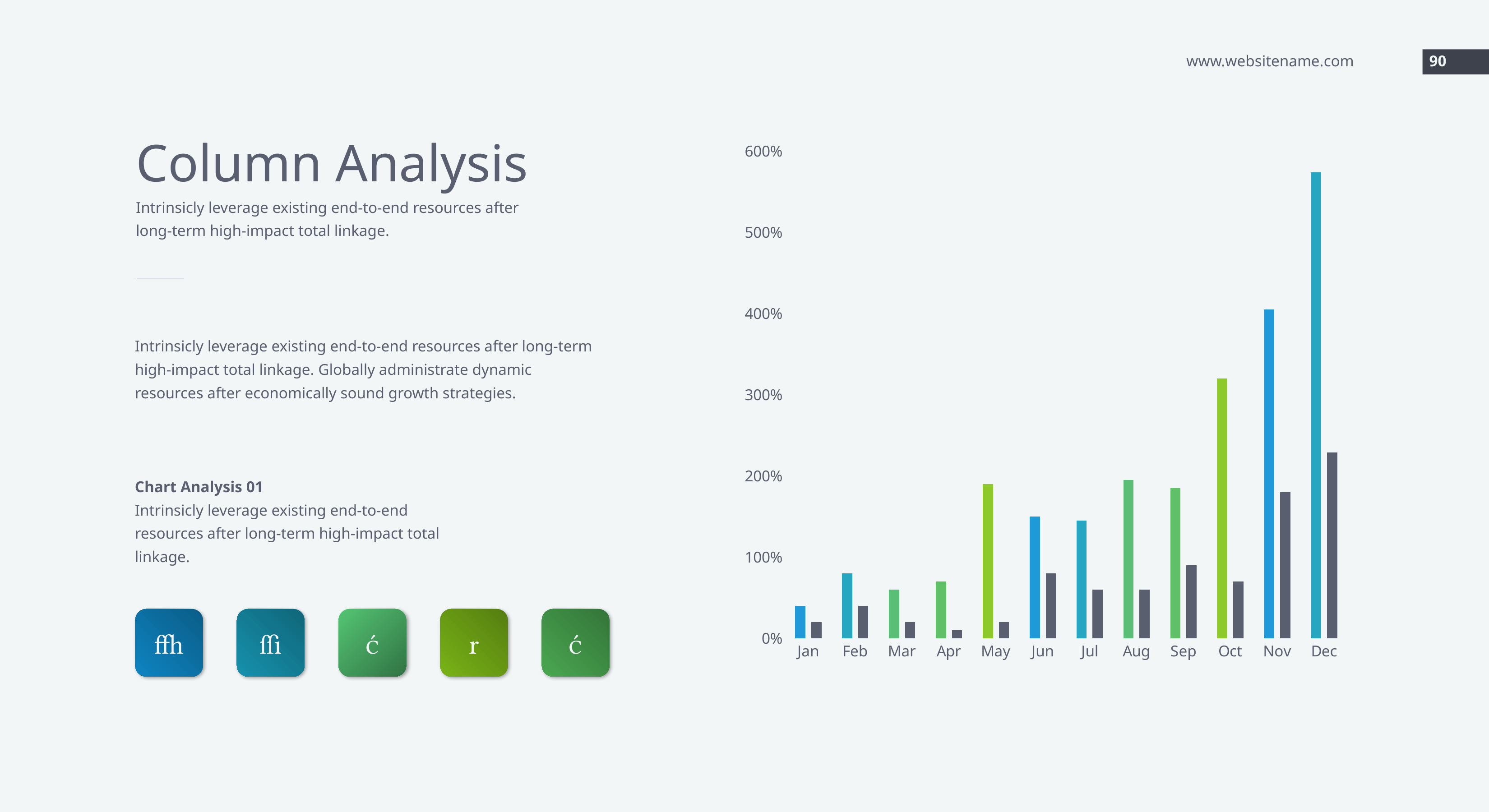
Which month has the shortest coloured bar in the chart? Jan Which has the taller coloured bar, Oct or Sep? Oct Is the coloured bar for Oct greater or less than 400%? less Which month has the shortest grey bar in the chart? Apr Is the coloured bar for Dec greater or less than 500%? greater Which month has the tallest coloured bar in the chart? Dec How many months are shown on the x axis of the chart? 12 Is the coloured bar for Jun greater or less than 100%? greater Which month has the tallest grey bar in the chart? Dec Do the coloured bars generally rise or fall from Jan to Dec? rise What kind of chart is shown on the slide? bar chart